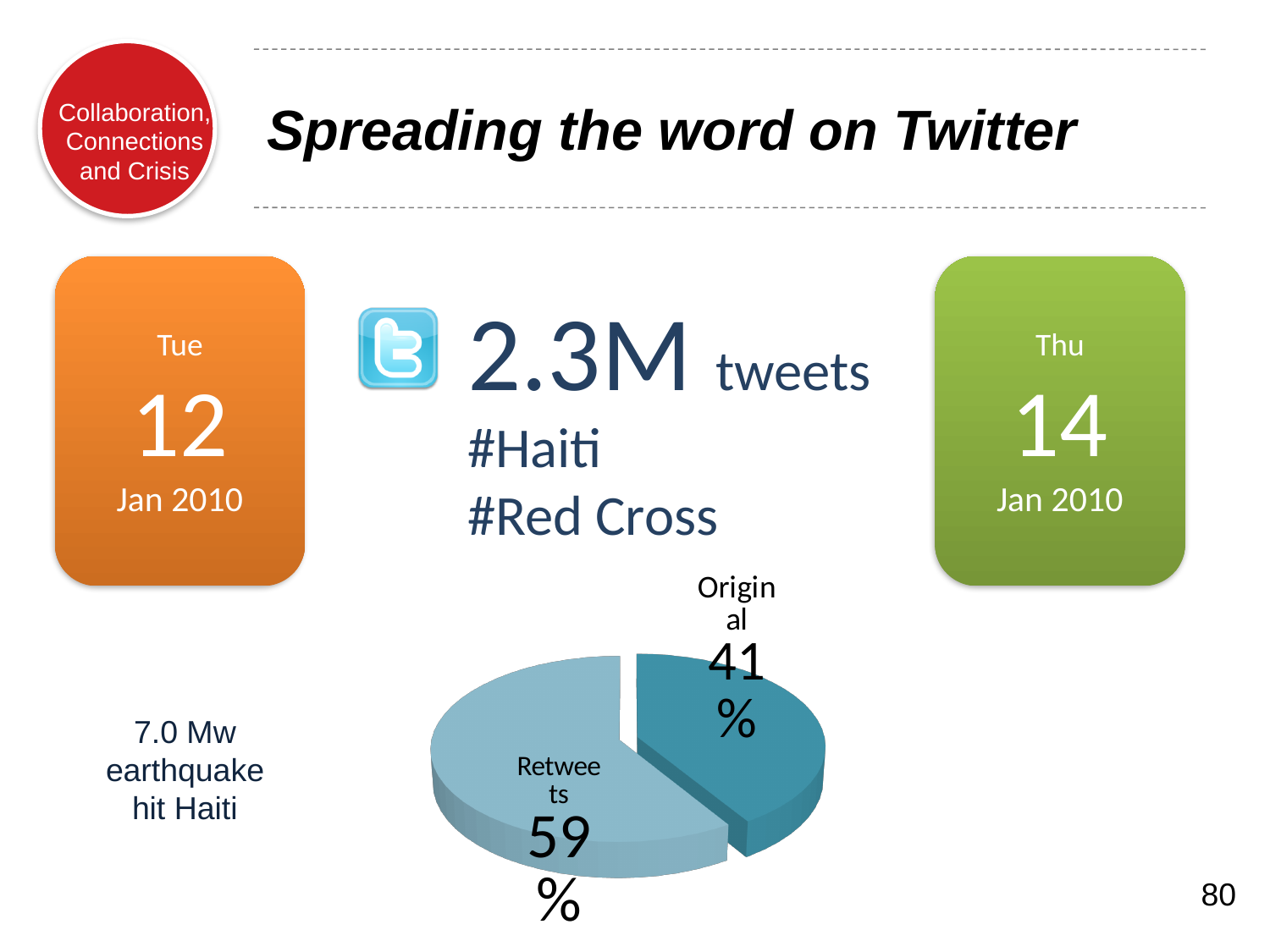
What share of the pie chart is labelled Retweets? 59% What is the difference in percentage points between the Retweets slice and the Original slice? 18 What kind of chart is shown on the slide? Pie chart What share of the pie chart is labelled Original? 41% How many slices does the pie chart have? 2 Which is larger in the pie chart, Retweets or Original? Retweets What is the total of the two slices shown in the pie chart? 100% What is the title of the slide containing the pie chart? Spreading the word on Twitter Which slice of the pie chart is drawn in the darker blue colour? Original Which slice of the pie chart is the largest? Retweets Which slice of the pie chart is the smallest? Original Is the Retweets slice greater or less than half of the pie? greater